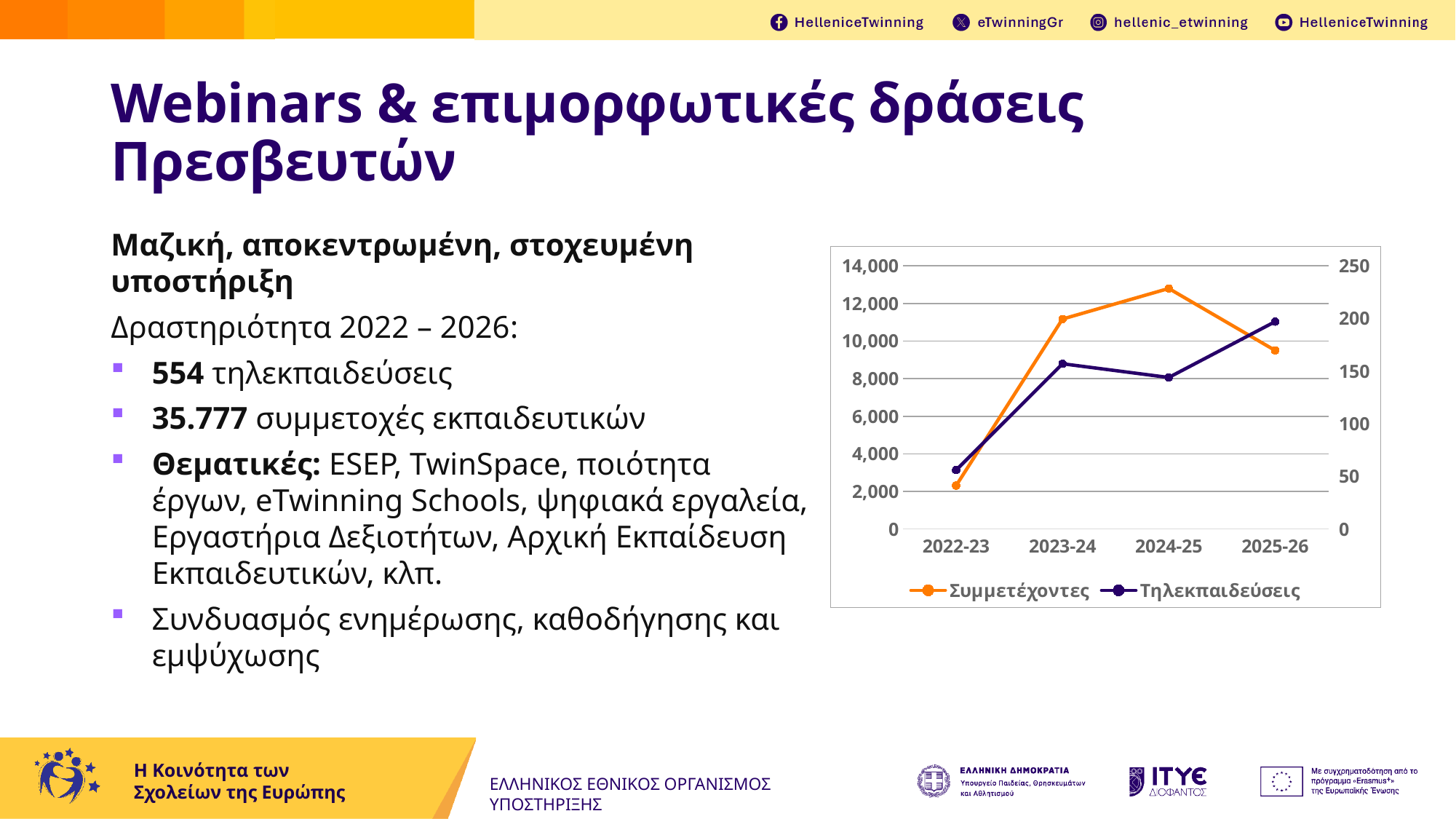
What kind of chart is shown on the slide? line chart Is the value for Συμμετέχοντες in 2025-26 greater or less than 10,000? less Is the value for Τηλεκπαιδεύσεις in 2025-26 greater or less than 150? greater How many school-year categories are shown on the x axis of the chart? 4 Is the value for Τηλεκπαιδεύσεις in 2022-23 greater or less than 100? less How many series does the chart legend list? 2 In which school year is the Συμμετέχοντες series at its lowest? 2022-23 Which is larger for Συμμετέχοντες: the value in 2023-24 or the value in 2025-26? 2023-24 Does the Συμμετέχοντες series rise or fall from 2024-25 to 2025-26? fall In which school year is the Τηλεκπαιδεύσεις series at its highest? 2025-26 In which school year is the Συμμετέχοντες series at its highest? 2024-25